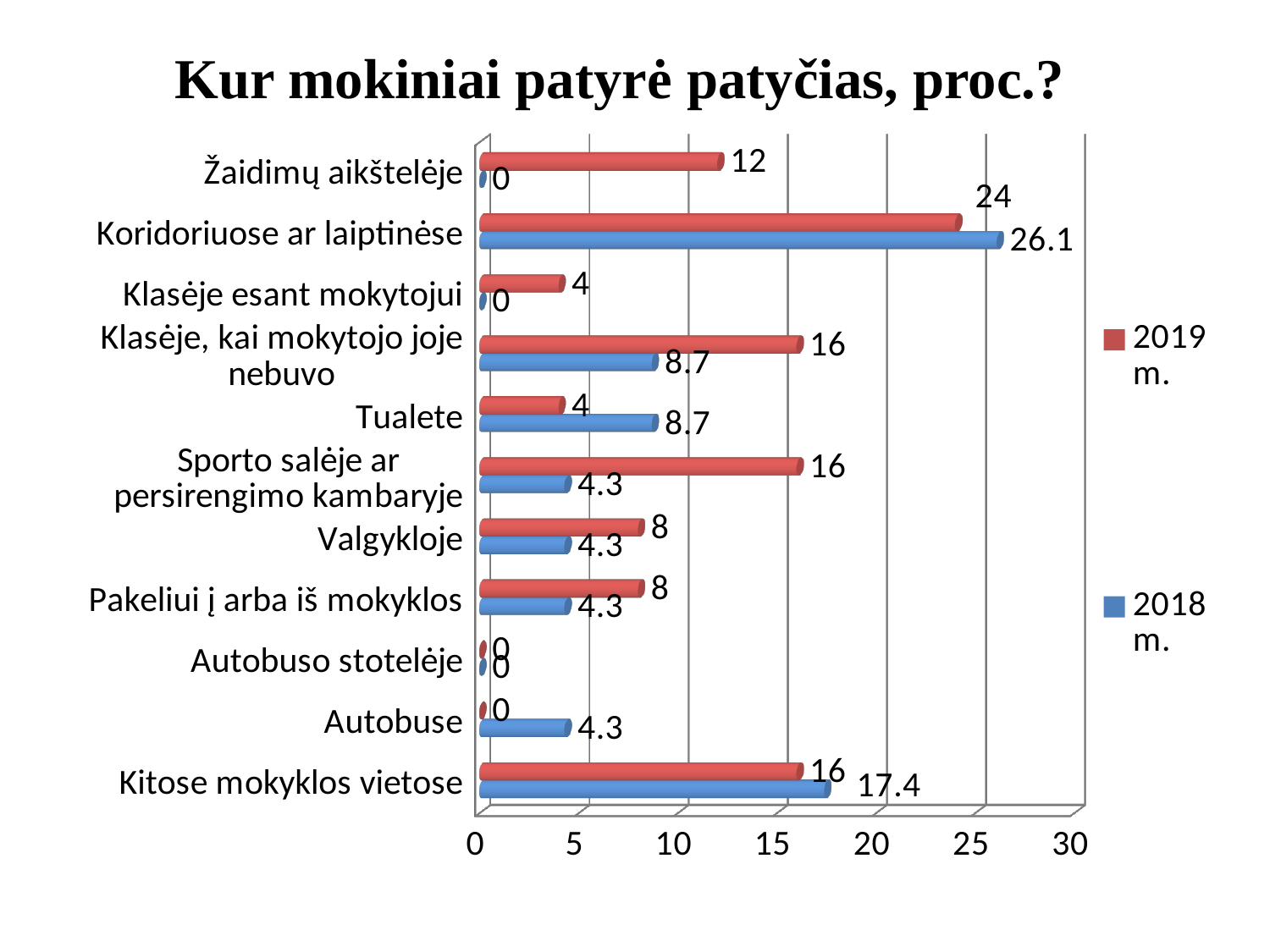
What is the difference between the 2018 m. and 2019 m. values for Koridoriuose ar laiptinėse? 2.1 Which category has the highest 2018 m. value? Koridoriuose ar laiptinėse Which category has the highest 2019 m. value? Koridoriuose ar laiptinėse For Tualete, which series has the larger value, 2019 m. or 2018 m.? 2018 m. What is the 2018 m. value for Kitose mokyklos vietose? 17.4 What kind of chart is shown on the slide? Bar chart What is the difference between the 2019 m. and 2018 m. values for Sporto salėje ar persirengimo kambaryje? 11.7 What is the title of the chart? Kur mokiniai patyrė patyčias, proc.? What is the 2018 m. value for Tualete? 8.7 How many series does the legend list? 2 How many categories are shown on the chart? 11 What is the 2019 m. value for Koridoriuose ar laiptinėse? 24